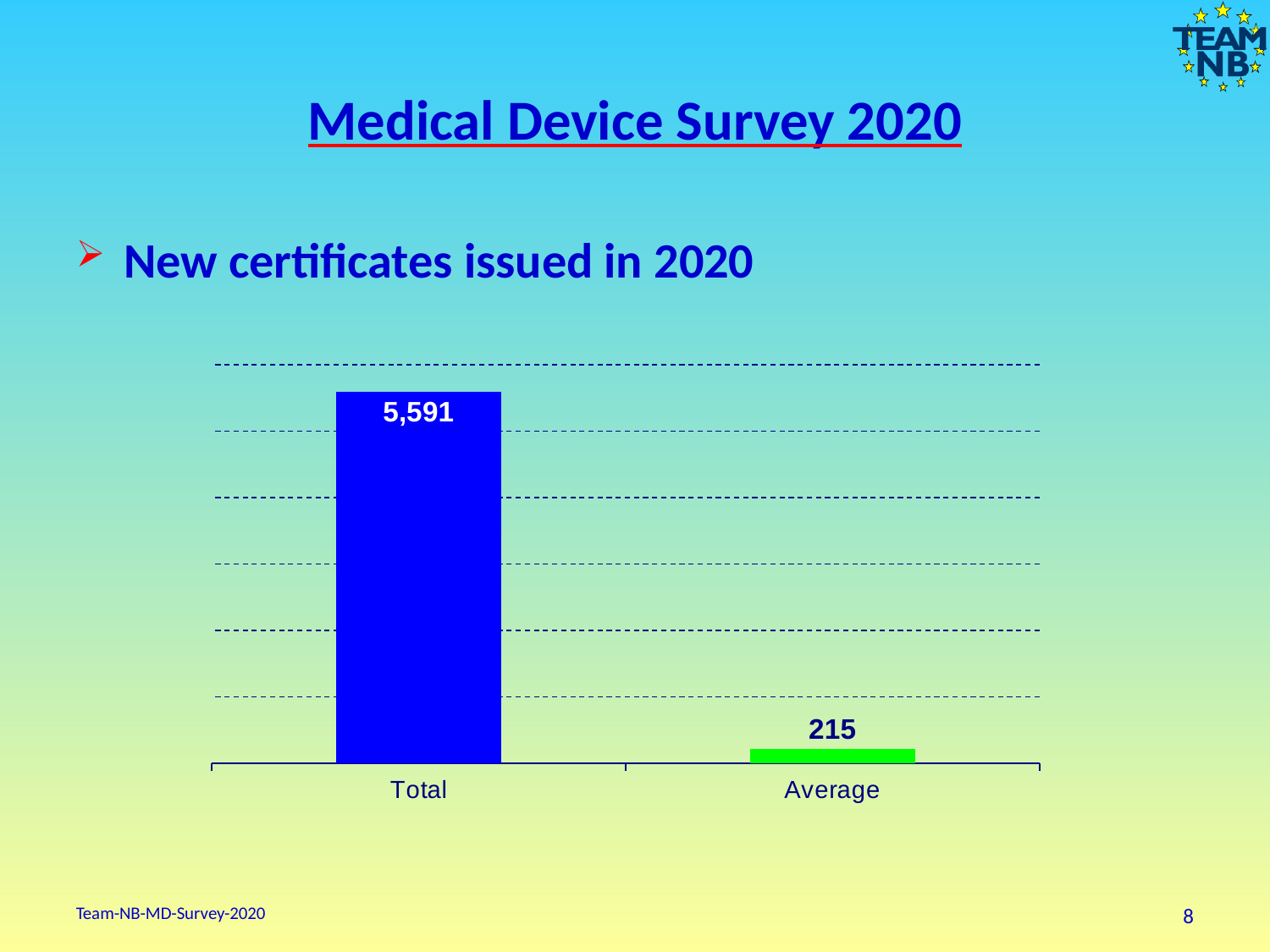
Which is larger, the value for Total or the value for Average? Total What colour is the Average bar? green What is the difference between the Total and Average values? 5,376 Which category has the lowest value? Average What colour is the Total bar? blue What is the value of the Average bar? 215 What is the value of the Total bar? 5,591 How many categories are shown on the x axis? 2 What kind of chart is shown on the slide? bar chart Which category has the highest value? Total